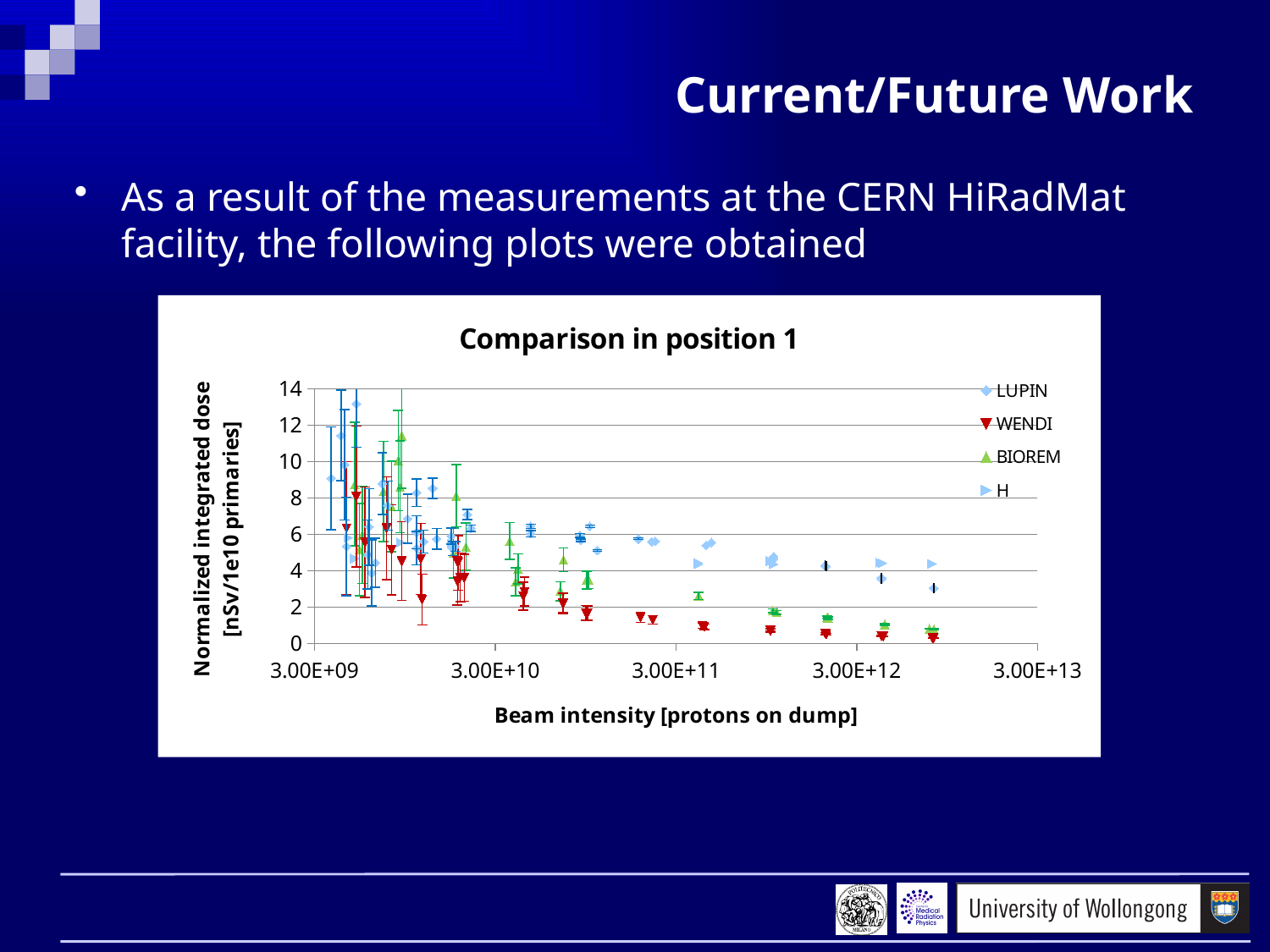
How many series does the chart's legend list? 4 Do the plotted dose values generally rise or fall as beam intensity increases along the x axis? Fall What is the title of the chart? Comparison in position 1 What is the highest value shown on the y axis of the chart? 14 Which series has the lowest values at the highest beam intensities? WENDI Which series has the highest values at the highest beam intensities? H At a beam intensity of about 3.00E+12, which series has the larger value, H or WENDI? H How many tick labels are shown on the x axis of the chart? 5 What kind of chart is shown on the slide? Scatter chart What is the label of the x axis of the chart? Beam intensity [protons on dump] At a beam intensity of about 3.00E+12, is the WENDI value greater or less than 2? less At a beam intensity of about 3.00E+12, is the H value greater or less than 2? greater